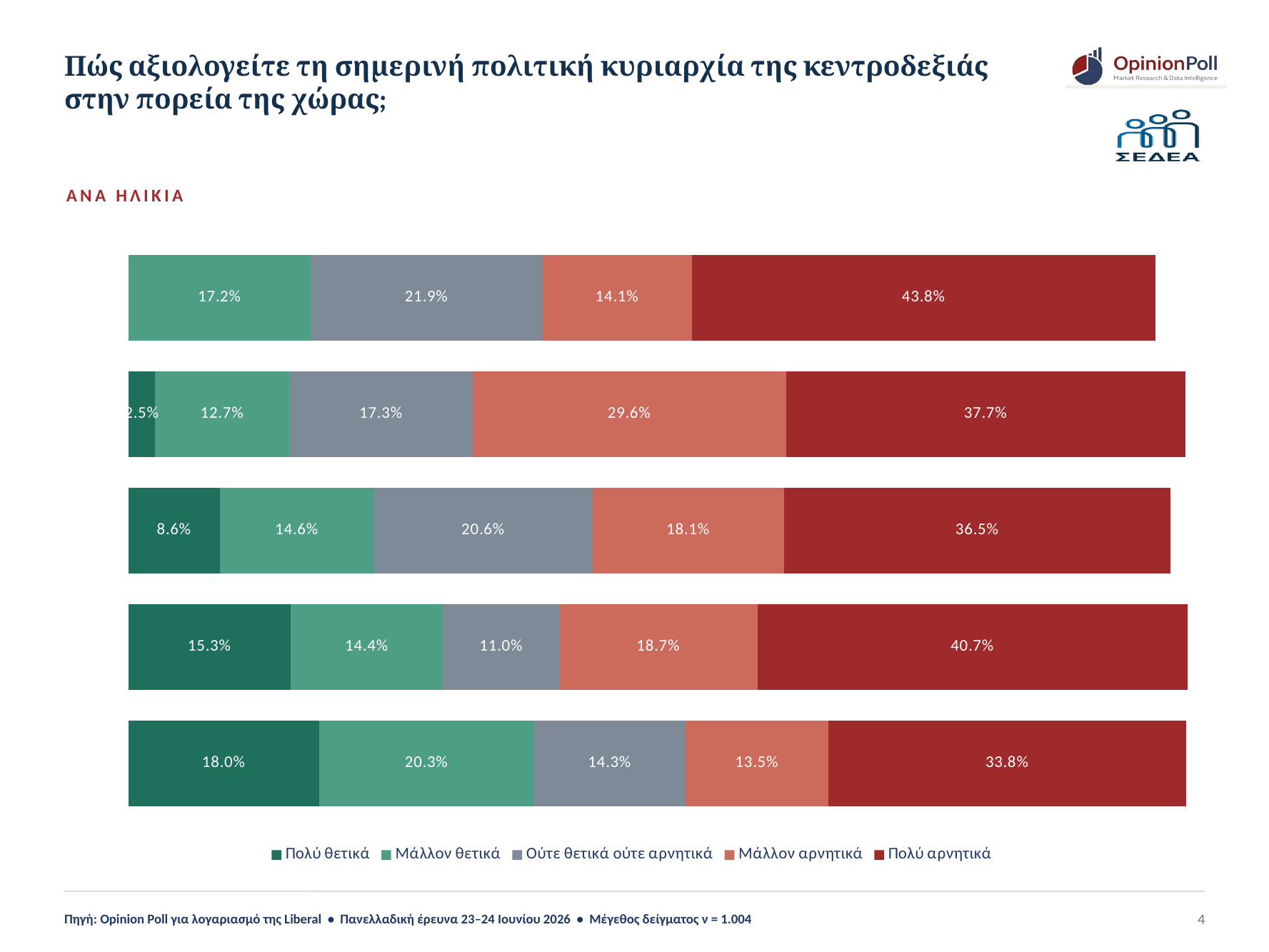
What is the value of the 'Πολύ θετικά' segment in the bottom bar? 18.0% Which bar has the highest 'Πολύ αρνητικά' value? The top bar (43.8%) How many stacked bars does the chart show? 5 What is the value of the 'Ούτε θετικά ούτε αρνητικά' segment in the middle (third) bar? 20.6% How many series does the legend list? 5 What colour represents 'Πολύ αρνητικά' in the legend? Dark red What kind of chart is shown on the slide? Stacked bar chart What is the value of the 'Μάλλον αρνητικά' segment in the second bar from the top? 29.6% Which bar has the lowest 'Πολύ αρνητικά' value? The bottom bar (33.8%) In the fourth bar from the top, which is larger: 'Μάλλον αρνητικά' or 'Ούτε θετικά ούτε αρνητικά'? Μάλλον αρνητικά (18.7%) What is the value of the 'Πολύ αρνητικά' segment in the top bar? 43.8% In the bottom bar, what is the difference between the 'Μάλλον θετικά' and 'Πολύ θετικά' values? 2.3 percentage points